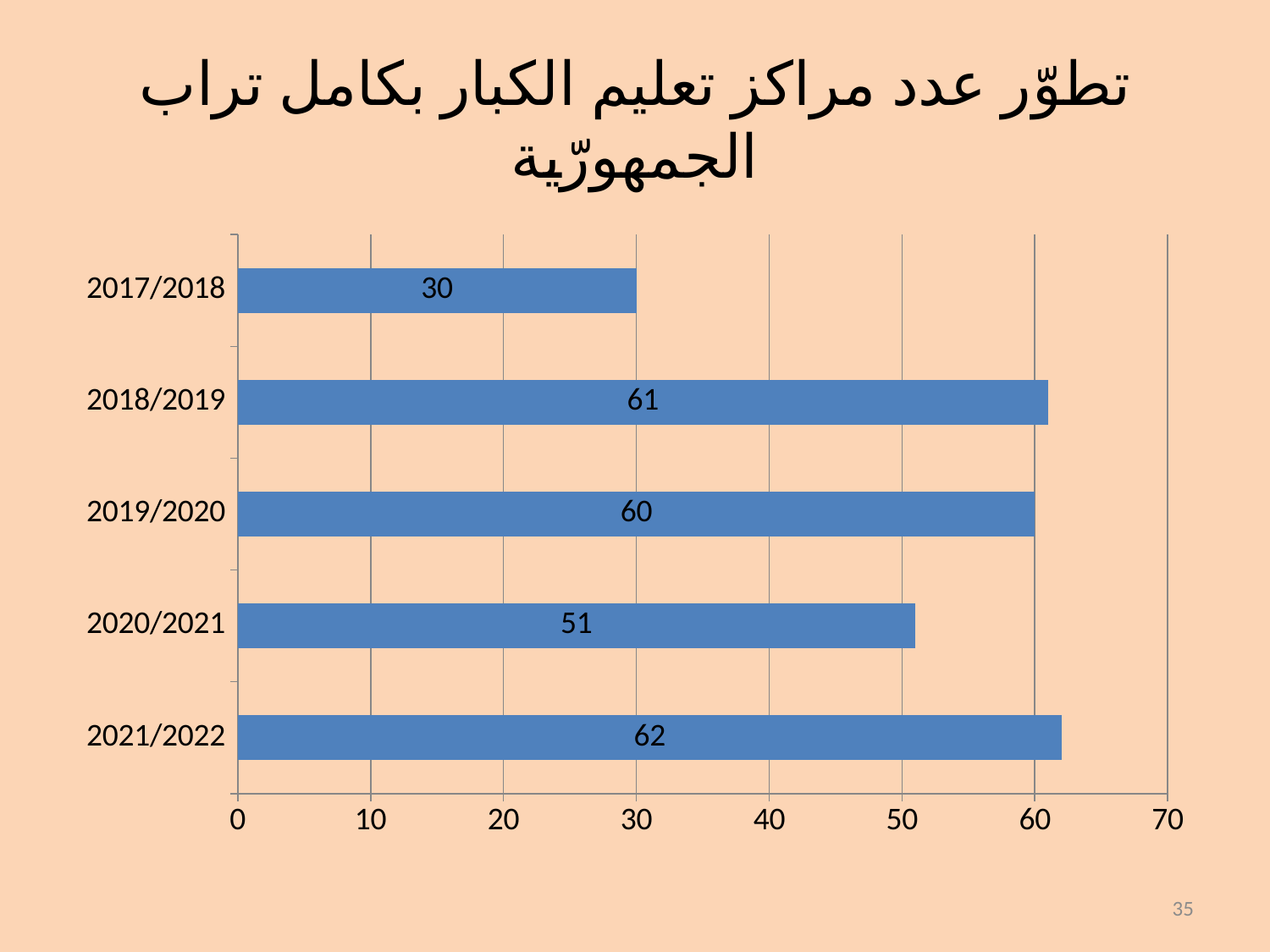
What is the value for 2021/2022? 62 What is the maximum value shown on the horizontal axis? 70 What kind of chart is shown on the slide? bar chart What is the difference between the values for 2018/2019 and 2017/2018? 31 Which is larger, the value for 2019/2020 or the value for 2020/2021? 2019/2020 Which year has the highest value? 2021/2022 What is the value for 2020/2021? 51 What is the value for 2017/2018? 30 How many years are shown in the chart? 5 Which year has the lowest value? 2017/2018 Is the value for 2020/2021 greater or less than 40? greater What is the difference between the values for 2021/2022 and 2020/2021? 11